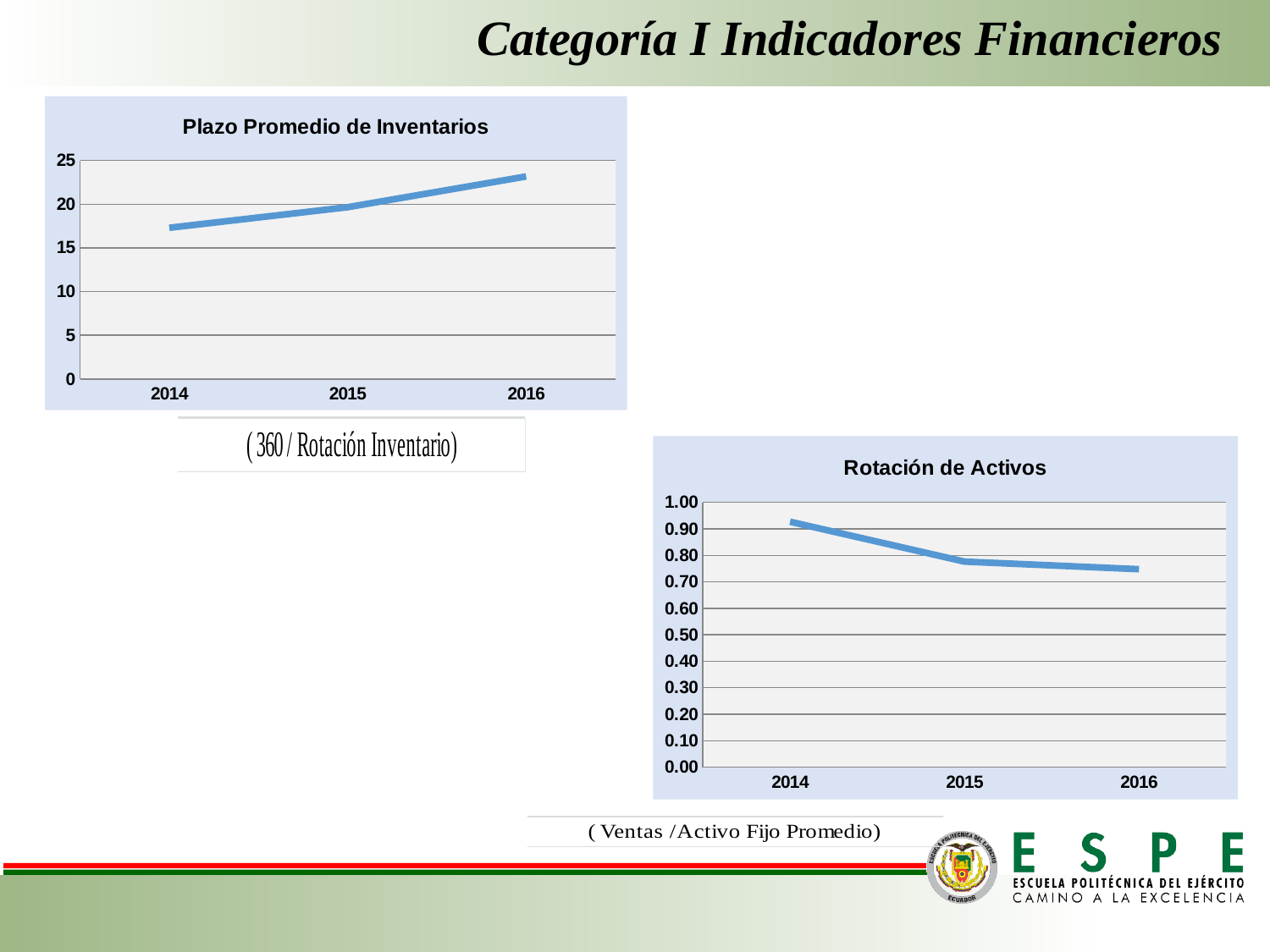
In the "Plazo Promedio de Inventarios" chart, is the value for 2014 greater or less than 20? less In the "Plazo Promedio de Inventarios" chart, is the value for 2016 greater or less than 20? greater In the "Plazo Promedio de Inventarios" chart, how many years are plotted on the x axis? 3 In the "Plazo Promedio de Inventarios" chart, do the values rise or fall from 2014 to 2016? rise In the "Rotación de Activos" chart, which is larger, the value for 2014 or the value for 2016? 2014 In the "Rotación de Activos" chart, how many data points are plotted? 3 In the "Plazo Promedio de Inventarios" chart, which year has the highest value? 2016 What type of chart is "Rotación de Activos"? line chart In the "Rotación de Activos" chart, is the value for 2016 greater or less than 0.80? less In the "Rotación de Activos" chart, do the values rise or fall from 2014 to 2016? fall In the "Rotación de Activos" chart, which year has the highest value? 2014 What type of chart is "Plazo Promedio de Inventarios"? line chart